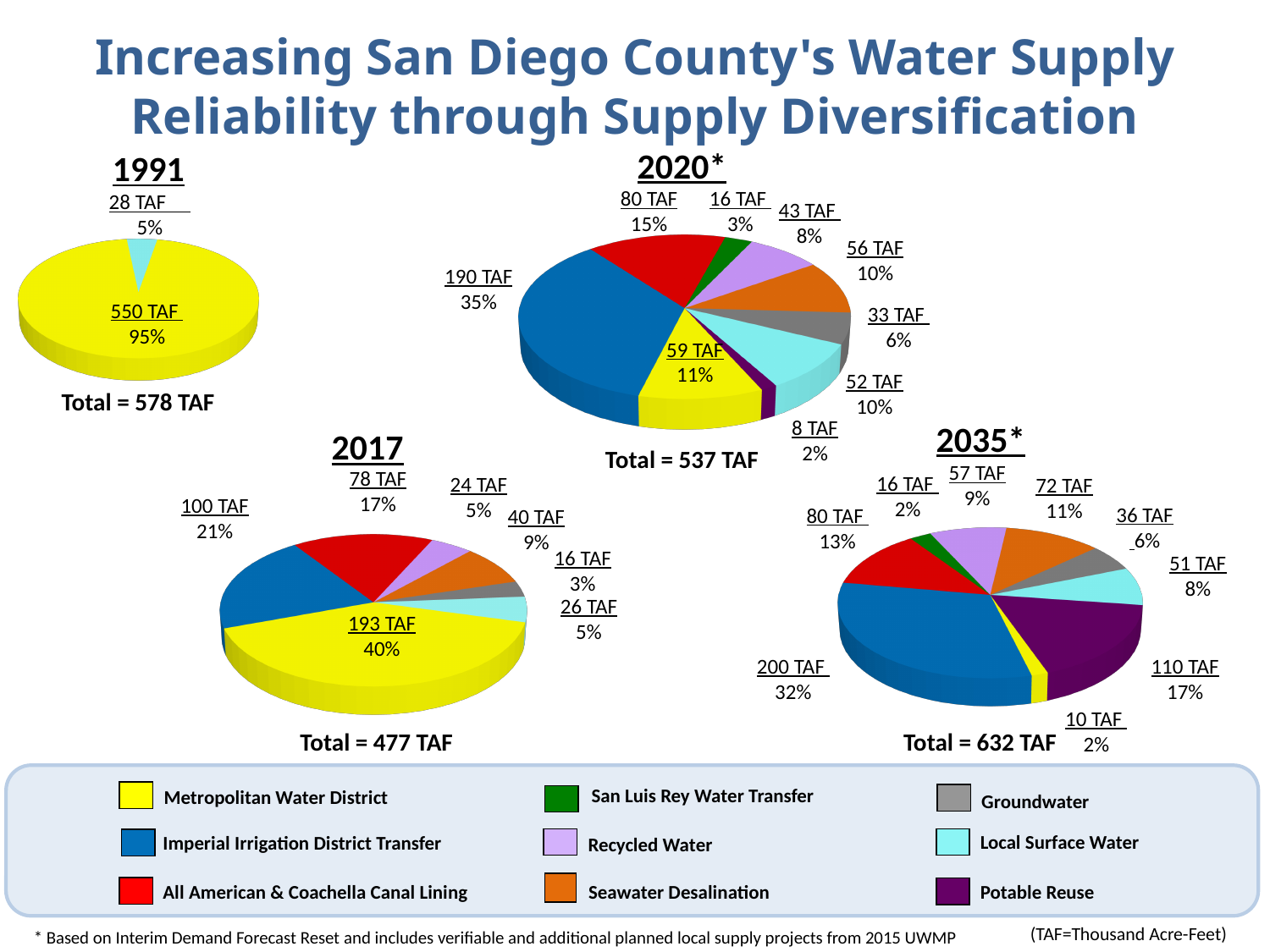
In the 2035* pie chart, what is the difference between Imperial Irrigation District Transfer and All American & Coachella Canal Lining? 120 TAF In the 1991 pie chart, what is the value for Metropolitan Water District? 550 TAF In the 2035* pie chart, what is the value for Potable Reuse? 110 TAF In the 2017 pie chart, what is the value for Imperial Irrigation District Transfer? 100 TAF What kind of charts are shown on the slide? Pie charts In the 2035* pie chart, which is larger: Recycled Water or Local Surface Water? Recycled Water What is the total shown for the 2020* pie chart? 537 TAF In the 2020* pie chart, which source is the smallest? Potable Reuse How many sources does the legend list? 9 In the 2017 pie chart, which source is the largest? Metropolitan Water District In the 1991 pie chart, what share of the total does Local Surface Water represent? 5% In the 2020* pie chart, what is the value for Seawater Desalination? 56 TAF